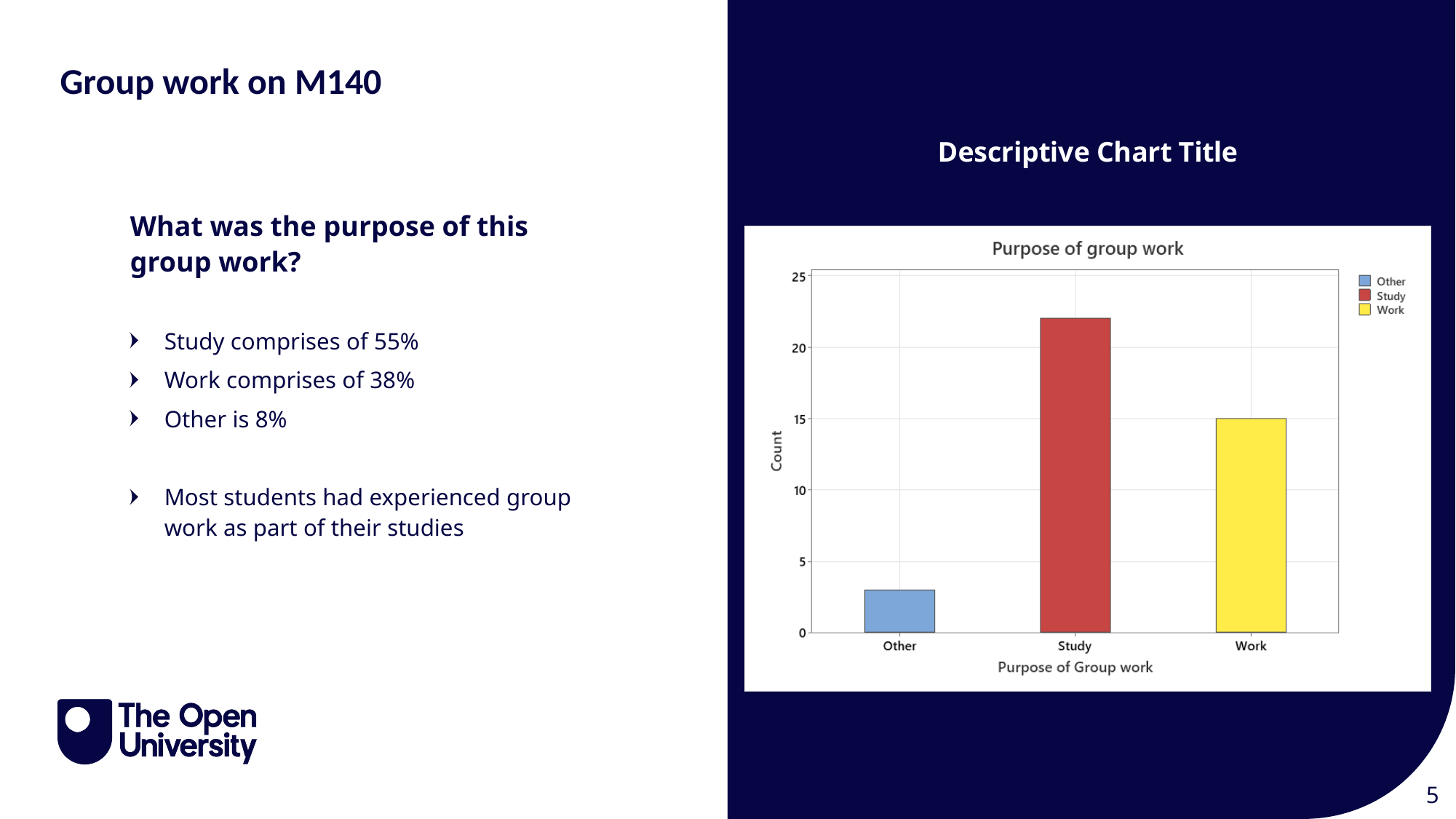
Which has a larger count, Work or Other? Work Which category has the highest count in the chart? Study What is the title of the chart? Purpose of group work How many categories are shown on the x axis of the chart? 3 Is the count for Study greater or less than 20? greater What is the label on the y axis of the chart? Count Which has a larger count, Study or Work? Study How many entries does the chart's legend list? 3 Is the count for Other greater or less than 5? less What is the count for Work in the chart? 15 Which category has the lowest count in the chart? Other What kind of chart is shown on the slide? bar chart